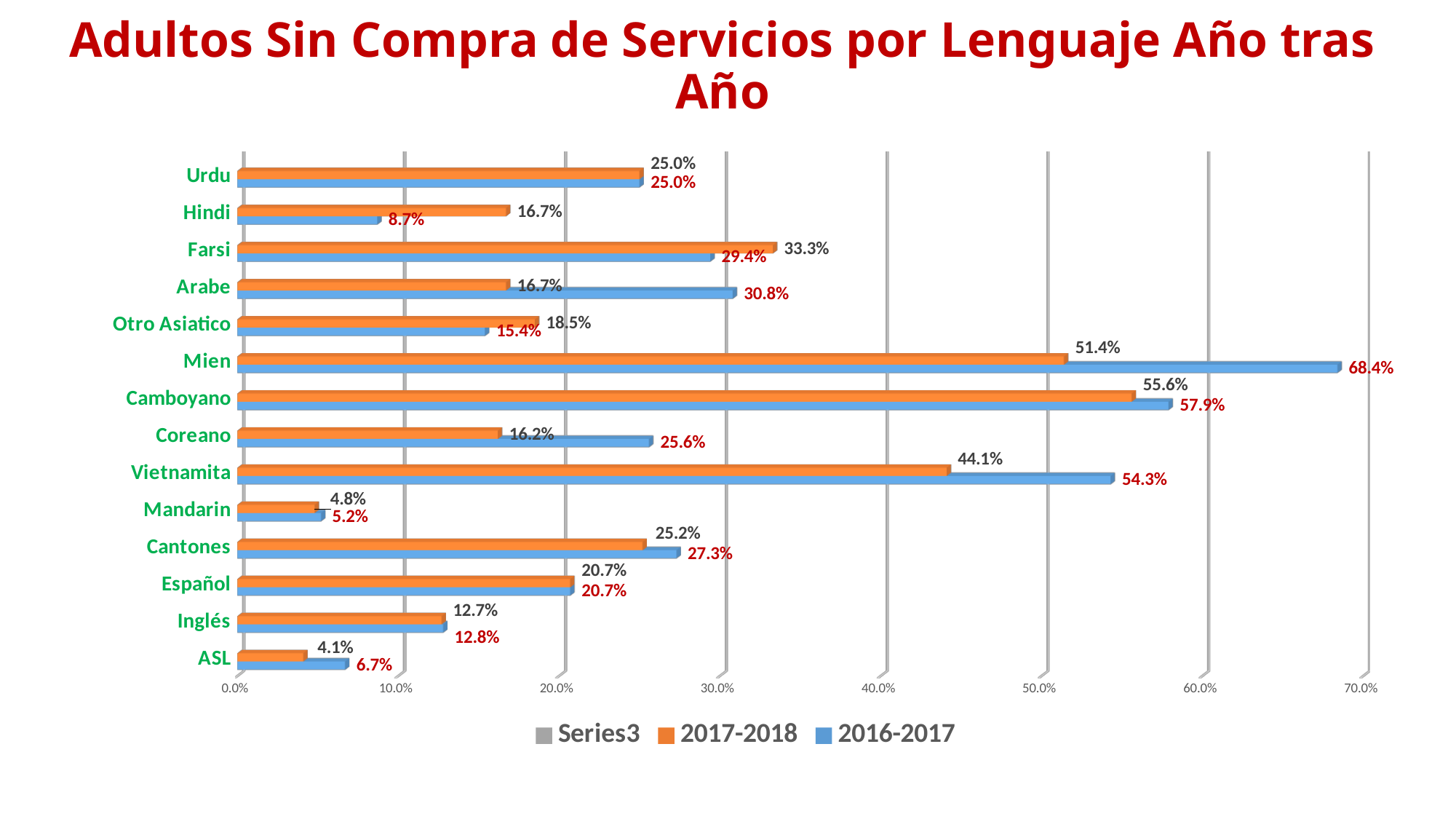
What is the difference between the 2016-2017 and 2017-2018 values for Mien? 17.0% What is the title of the chart? Adultos Sin Compra de Servicios por Lenguaje Año tras Año Which language has the highest 2017-2018 value? Camboyano Which language has the highest 2016-2017 value? Mien What type of chart is shown on the slide? bar chart How many series does the legend list? 3 Which language has the lowest 2017-2018 value? ASL How many languages are listed on the chart? 14 For Hindi, which is larger: the 2017-2018 value or the 2016-2017 value? 2017-2018 What is the 2016-2017 value for Arabe? 30.8% What is the 2017-2018 value for Farsi? 33.3% What is the 2016-2017 value for Mien? 68.4%